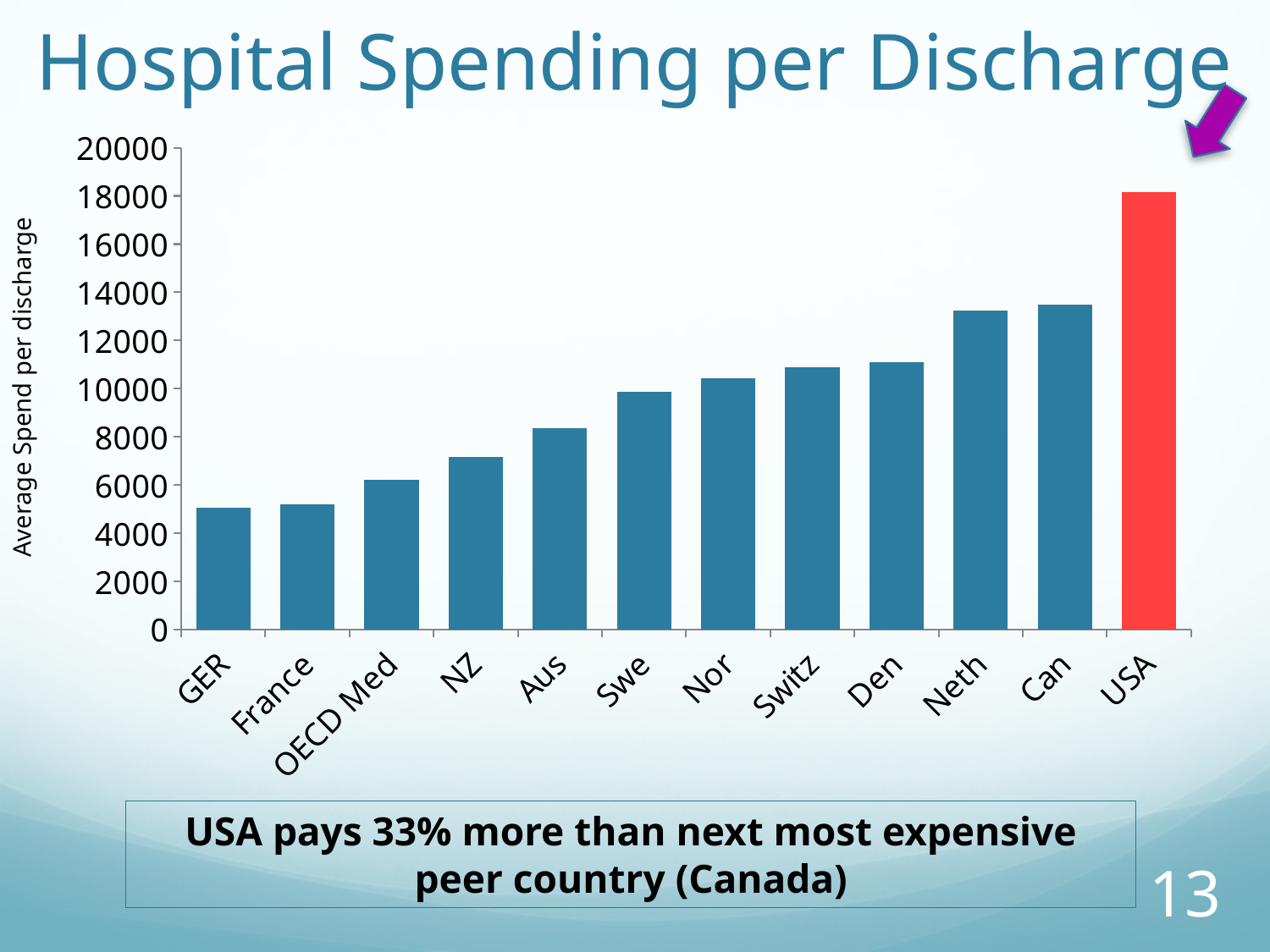
Which category has the highest average spend per discharge? USA Is the value for GER greater or less than 4000? greater Is the value for Den greater or less than 12000? less Is the value for NZ greater or less than 8000? less Do the bar values generally rise or fall moving from left to right along the x axis? rise How many countries/categories are shown on the x axis of the chart? 12 Which is larger, the value for USA or the value for Can? USA Which is larger, the value for Neth or the value for Aus? Neth What is the label on the vertical axis of the chart? Average Spend per discharge What kind of chart is shown on the slide? bar chart